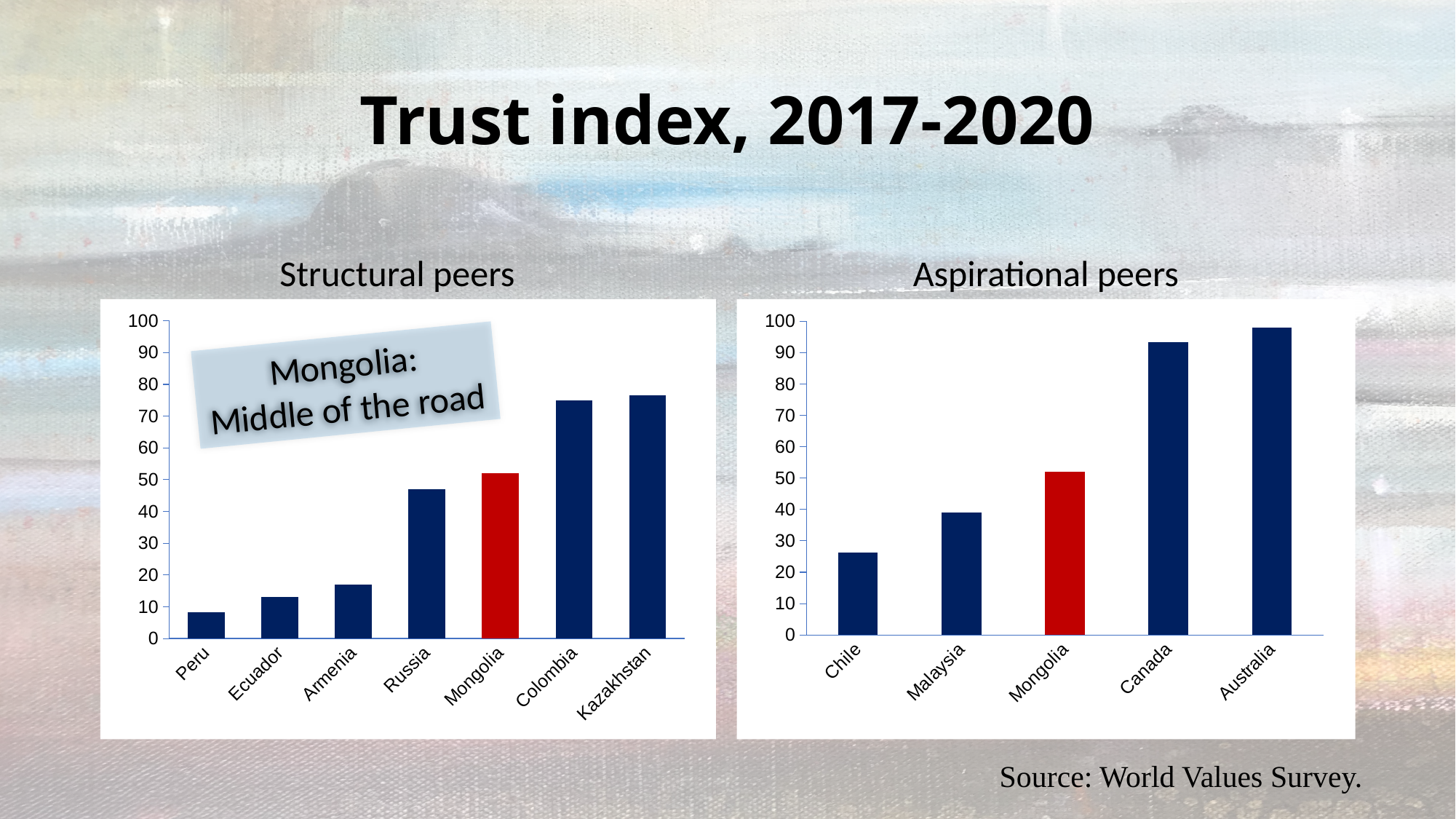
In the Structural peers chart, which country has the lowest trust index? Peru How many countries are shown in the Aspirational peers chart? 5 How many countries are shown in the Structural peers chart? 7 What kind of chart is the Structural peers chart? bar chart In the Structural peers chart, is the value for Russia greater or less than 50? less In the Aspirational peers chart, which country's bar is coloured red? Mongolia In the Aspirational peers chart, which country has the highest trust index? Australia In the Structural peers chart, do the values rise or fall from left to right along the x axis? rise In the Aspirational peers chart, which country has the lowest trust index? Chile In the Structural peers chart, is the value for Mongolia greater or less than 50? greater In the Aspirational peers chart, which is larger, the value for Canada or the value for Mongolia? Canada